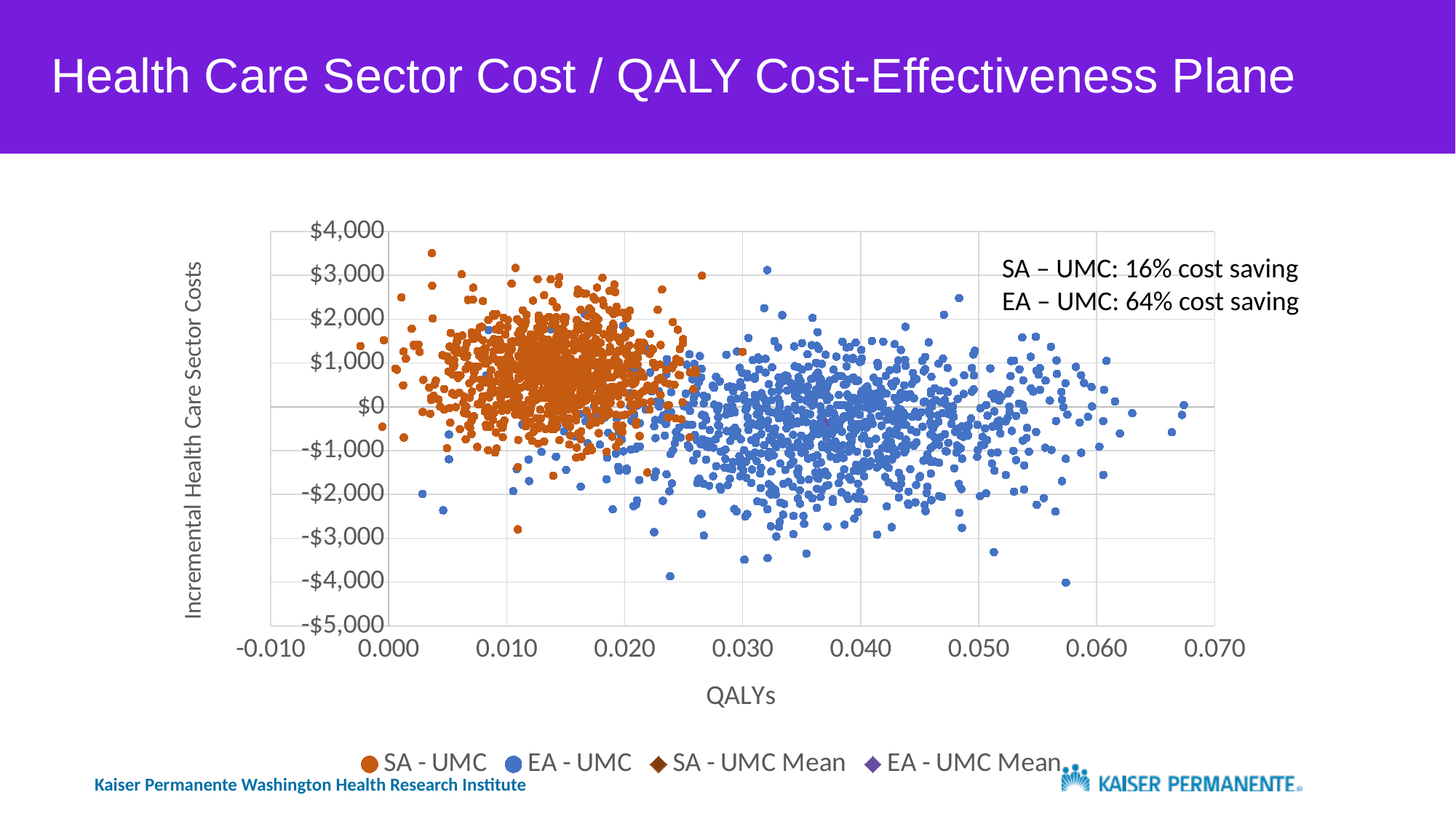
By how many percentage points does the EA – UMC cost saving exceed the SA – UMC cost saving? 48 percentage points How many series does the legend list? 4 What is the label of the vertical axis? Incremental Health Care Sector Costs Which series, SA - UMC or EA - UMC, has points clustered at higher incremental health care sector costs? SA - UMC What cost saving percentage is stated for SA – UMC? 16% cost saving Are most of the EA - UMC points at QALY values greater or less than 0.020? greater Which series, SA - UMC or EA - UMC, has points clustered at higher QALY values? EA - UMC Which comparison has the larger stated cost saving, SA – UMC or EA – UMC? EA – UMC Are most of the SA - UMC points at QALY values greater or less than 0.030? less What is the title of the chart? Health Care Sector Cost / QALY Cost-Effectiveness Plane What kind of chart is shown on the slide? Scatter plot What cost saving percentage is stated for EA – UMC? 64% cost saving